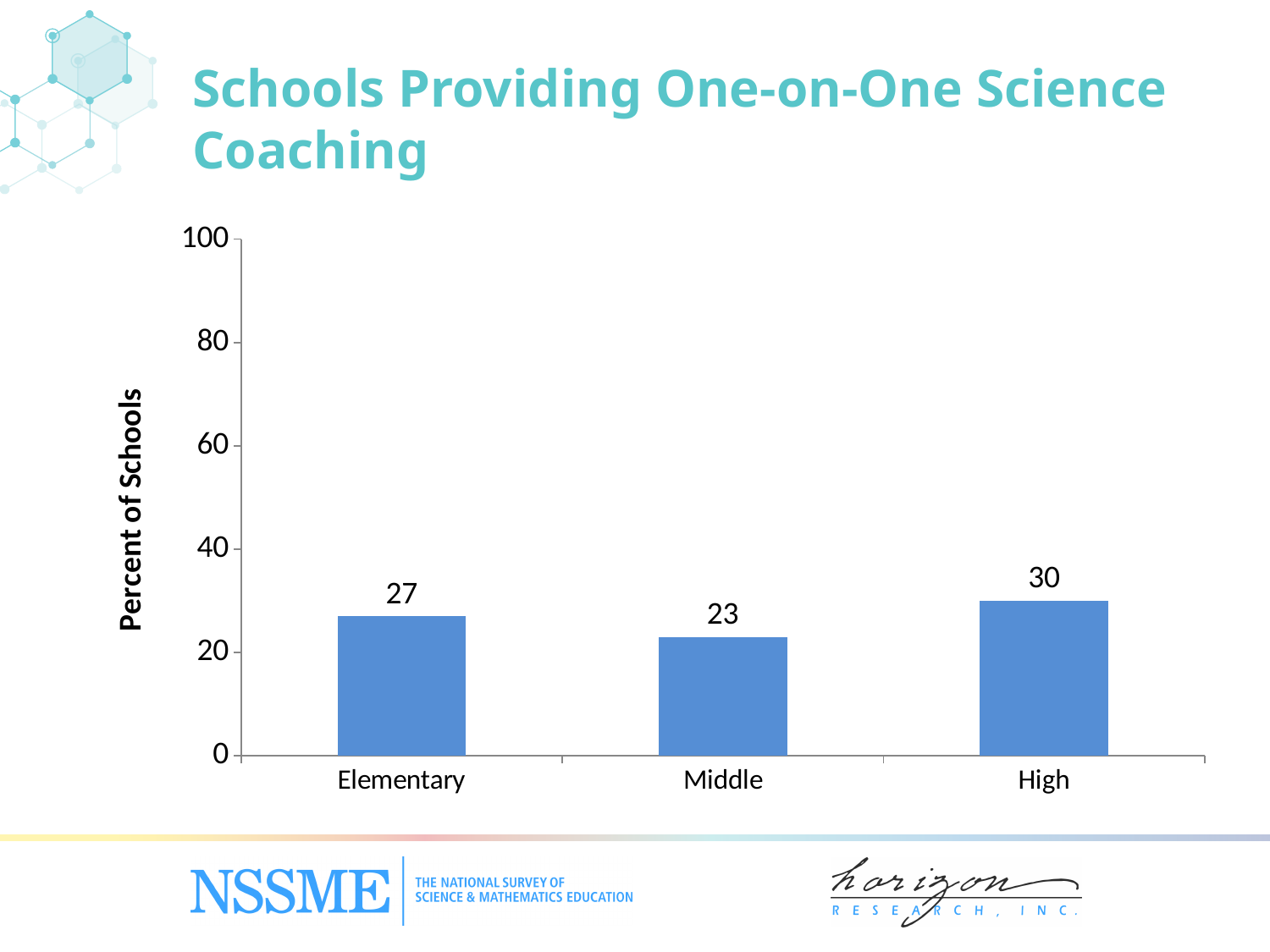
How many school levels are shown on the chart? 3 What percent of elementary schools provide one-on-one science coaching? 27 What is the label of the vertical axis? Percent of Schools Is the value for Middle schools greater or less than 40? less Which school level has the lowest value? Middle What is the value for Middle schools? 23 Which school level has the highest percent of schools providing one-on-one science coaching? High What is the difference between the values for Elementary and Middle schools? 4 What kind of chart is shown on the slide? bar chart Which is larger, the value for Elementary or the value for High? High What is the difference between the values for High and Middle schools? 7 What is the value for High schools? 30